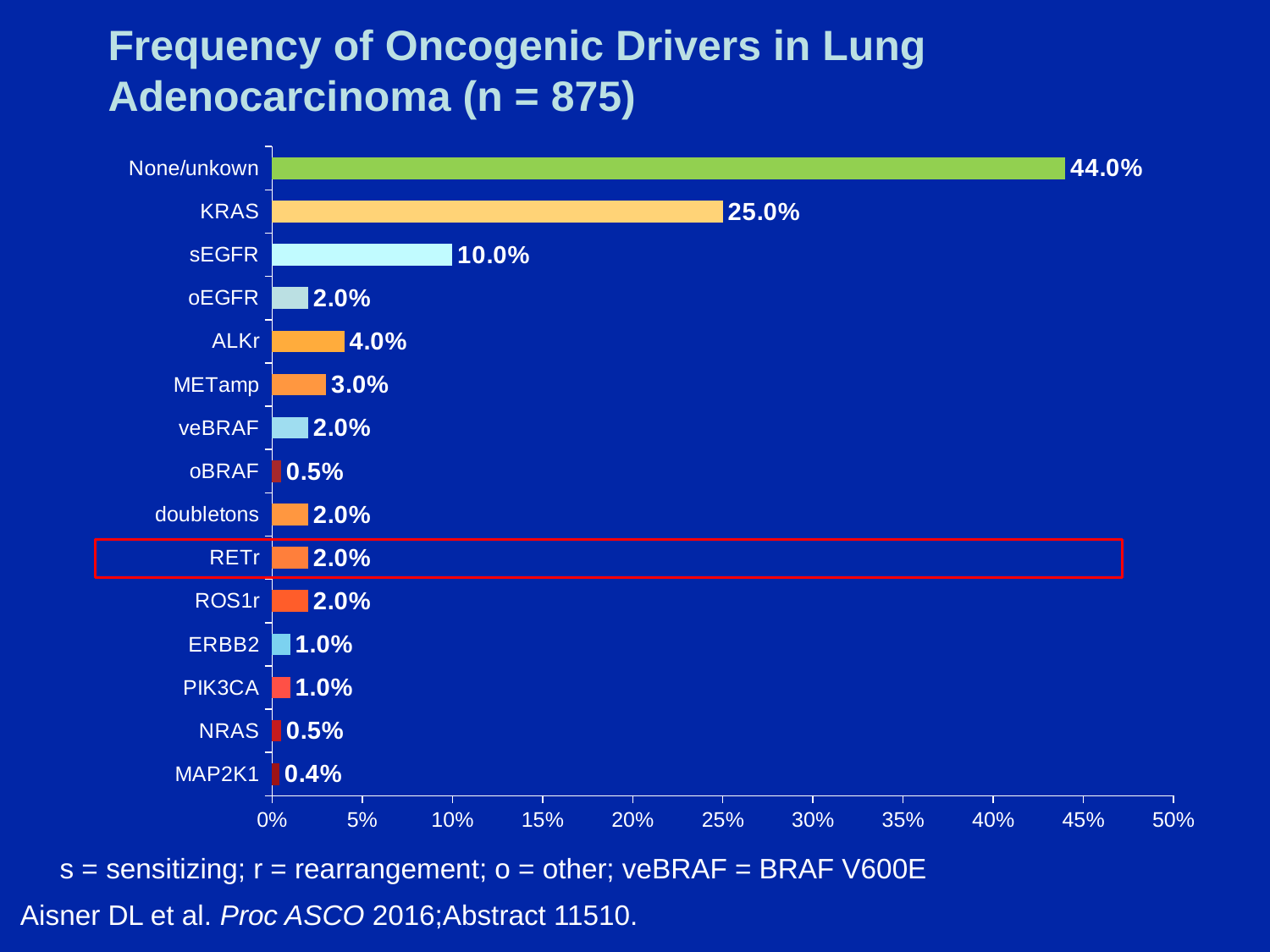
What is the difference between the values for KRAS and sEGFR? 15.0% Which is larger, the value for ALKr or the value for METamp? ALKr How many categories are shown on the chart? 15 Which category has the lowest value? MAP2K1 What is the value for RETr? 2.0% What is the value for MAP2K1? 0.4% What kind of chart is shown on the slide? bar chart Which category has the highest value? None/unkown What is the value for sEGFR? 10.0% What is the title of the chart? Frequency of Oncogenic Drivers in Lung Adenocarcinoma (n = 875) Is the value for None/unkown greater or less than 40%? greater What is the value for KRAS? 25.0%